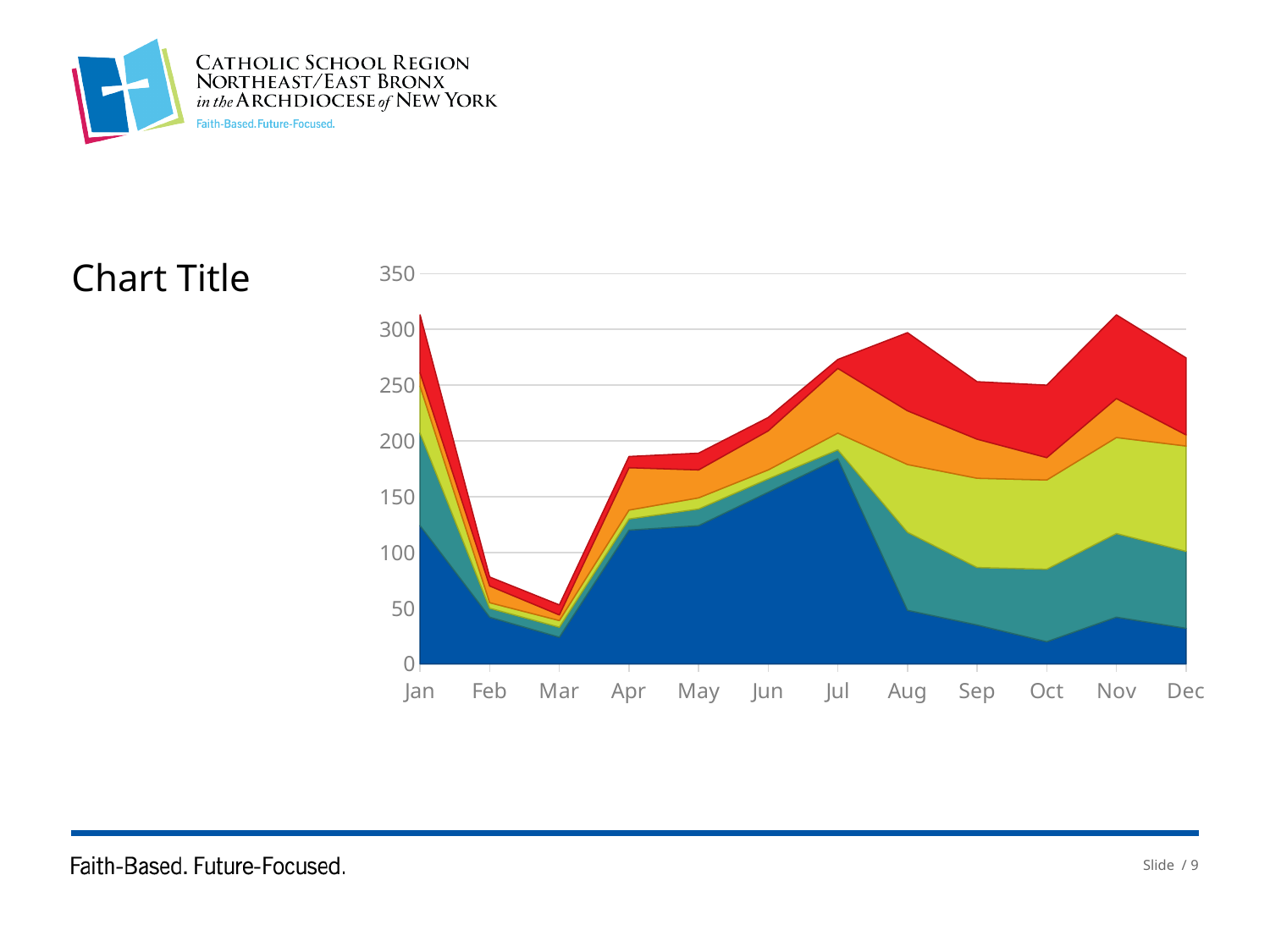
How many months are shown along the x axis of the chart? 12 Is the value of the bottom (dark blue) area for Jul greater or less than 150? greater In which month is the total stacked value lowest? Mar Does the total stacked value rise or fall from Mar to Jul? rise Which month has a larger total stacked value, Jul or Feb? Jul What kind of chart is shown on the slide? Stacked area chart Is the total stacked value for Feb greater or less than 100? less Is the total stacked value for Jul greater or less than 250? greater What is the title of the chart? Chart Title